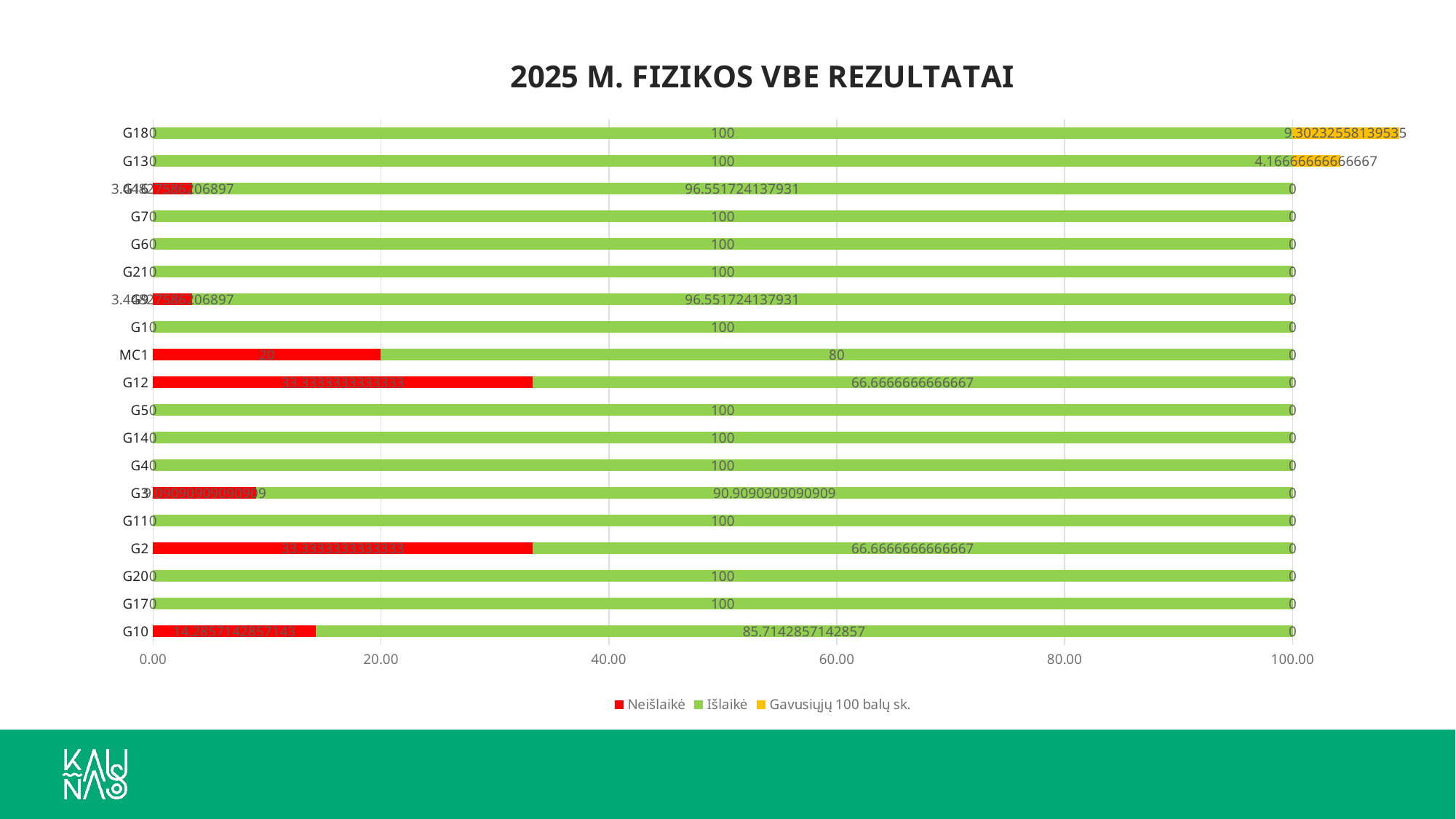
How many categories (bars) are plotted on the chart? 19 What kind of chart is shown on the slide? bar chart What is the Išlaikė value for G3? 90.9090909090909 Which has the larger Neišlaikė value, MC1 or G12? G12 What is the difference between the Išlaikė and Neišlaikė values for MC1? 60 What is the Išlaikė value for G10? 85.7142857142857 What is the Išlaikė value for MC1? 80 What is the Išlaikė value for G12? 66.6666666666667 How many series does the legend list? 3 What is the Neišlaikė value for MC1? 20 Which colour represents the Neišlaikė series in the legend? red What is the title of the chart? 2025 M. FIZIKOS VBE REZULTATAI